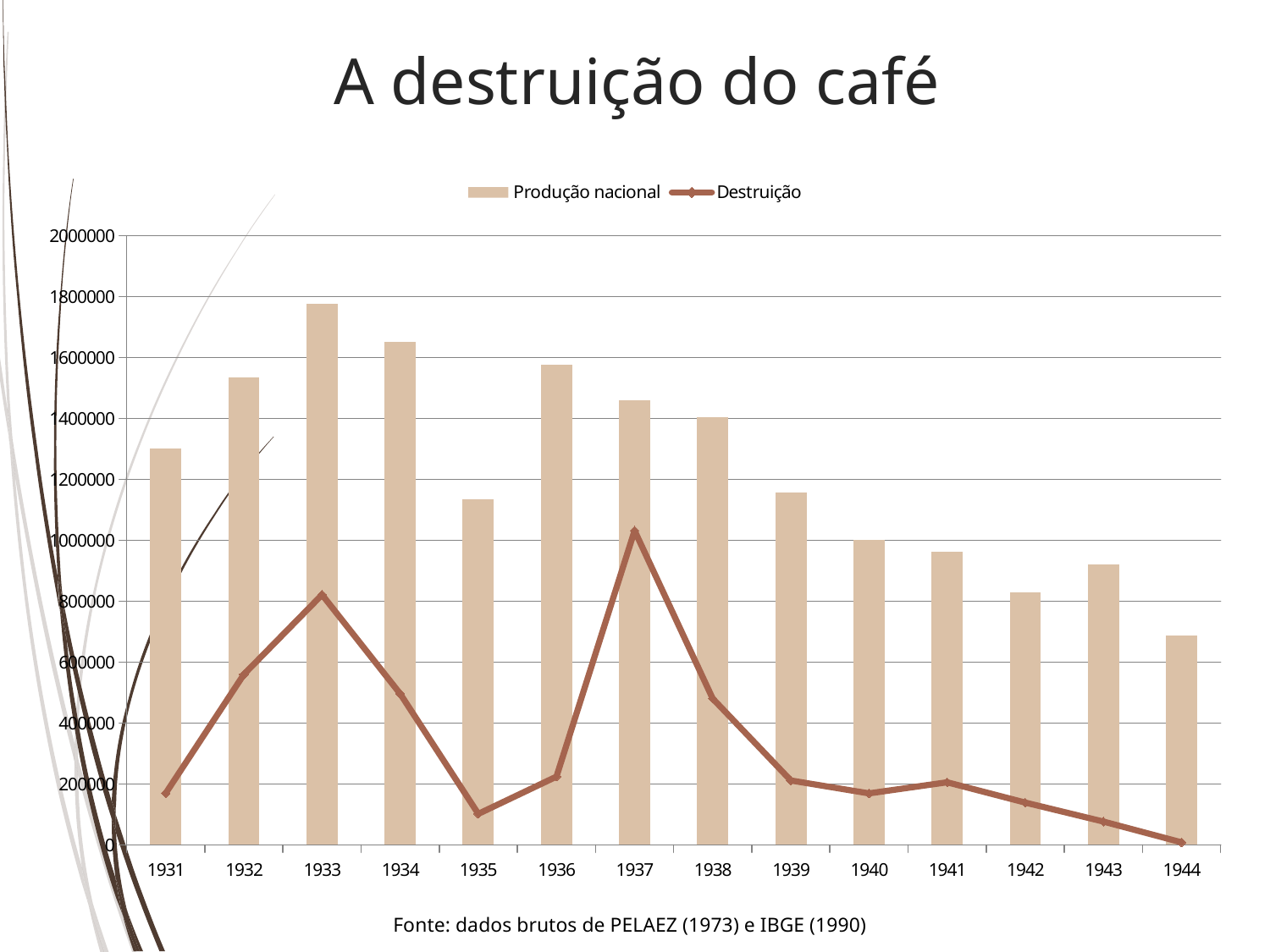
What kind of chart is shown on the slide? A combined bar and line chart Which year has the larger Produção nacional value, 1934 or 1935? 1934 Is the Produção nacional value for 1933 greater or less than 1600000? greater In which year is the Destruição line at its lowest? 1944 Is the Destruição value for 1935 greater or less than 200000? less Which year has the highest Produção nacional bar? 1933 Does the Produção nacional series generally rise or fall from 1937 to 1944? fall In which year does the Destruição line reach its highest point? 1937 How many series does the chart's legend list? 2 How many years are shown on the x axis of the chart? 14 Is the Produção nacional value for 1944 greater or less than 800000? less Which year has the lowest Produção nacional bar? 1944